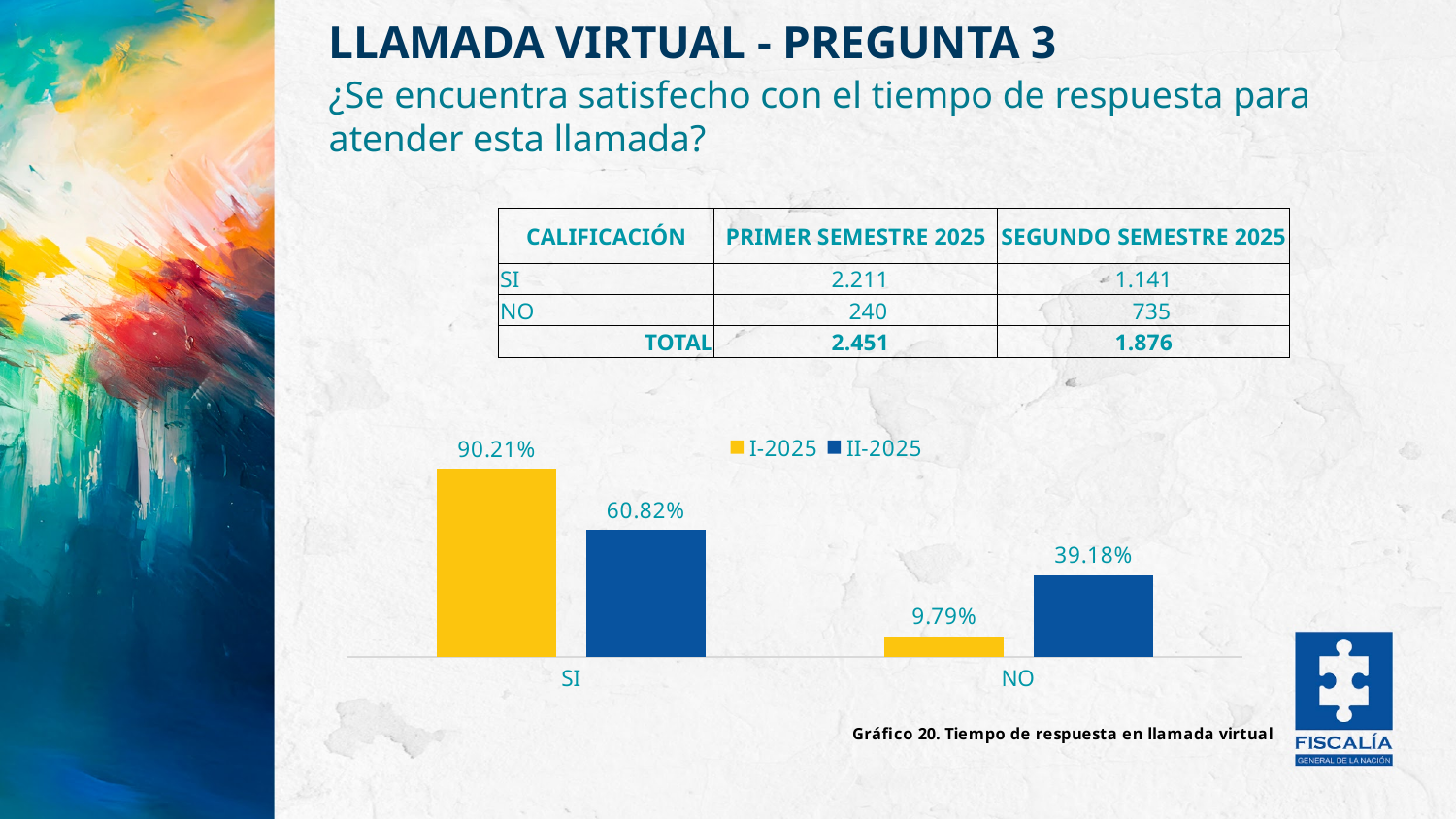
How many series does the chart legend list? 2 Which category has the lowest value in the II-2025 series? NO What is the value for SI in the II-2025 series? 60.82% How many categories are shown on the x axis of the chart? 2 What is the value for SI in the I-2025 series? 90.21% Which category has the highest value in the I-2025 series? SI Which colour represents the II-2025 series in the chart? Blue What is the difference between the I-2025 and II-2025 values for SI? 29.39% What kind of chart is shown on the slide? Bar chart What is the value for NO in the I-2025 series? 9.79% What is the value for NO in the II-2025 series? 39.18% Which is larger for NO: the I-2025 value or the II-2025 value? II-2025